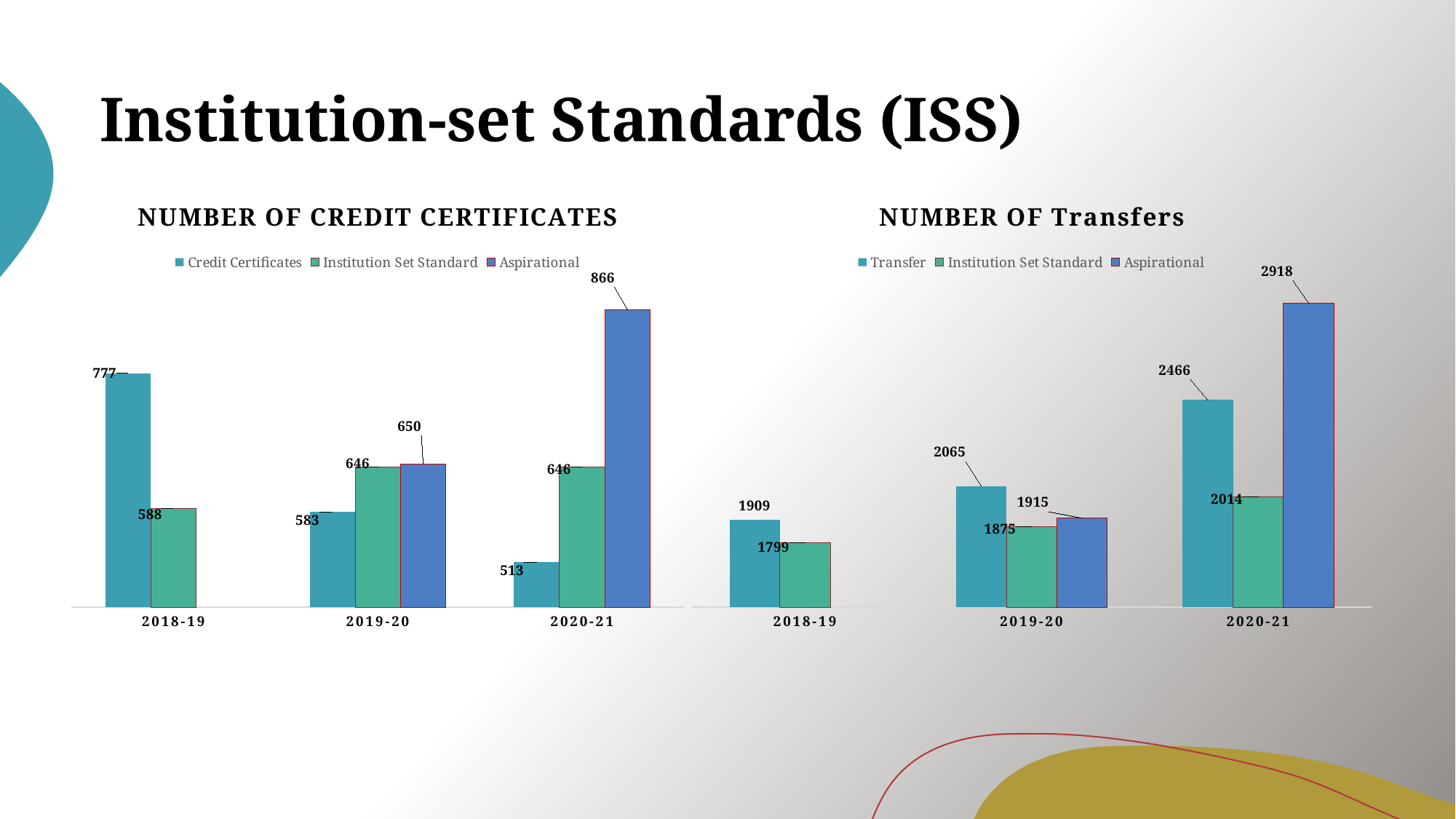
In the 'Number of Transfers' chart, what is the difference between the Transfer value and the Institution Set Standard value for 2018-19? 110 What type of chart is the 'Number of Transfers' chart? bar chart In the 'Number of Transfers' chart, how many series does the legend list? 3 In the 'Number of Credit Certificates' chart, which year has the lowest Credit Certificates value? 2020-21 In the 'Number of Transfers' chart, what is the Aspirational value for 2020-21? 2918 In the 'Number of Transfers' chart, which year has the highest Transfer value? 2020-21 In the 'Number of Credit Certificates' chart, what is the Institution Set Standard value for 2019-20? 646 In the 'Number of Credit Certificates' chart, do the Credit Certificates values rise or fall from 2018-19 to 2020-21? fall In the 'Number of Credit Certificates' chart, what is the Aspirational value for 2020-21? 866 In the 'Number of Transfers' chart, what is the Transfer value for 2019-20? 2065 In the 'Number of Credit Certificates' chart, what is the difference between the Aspirational value and the Credit Certificates value for 2020-21? 353 In the 'Number of Credit Certificates' chart, what is the value of Credit Certificates for 2018-19? 777